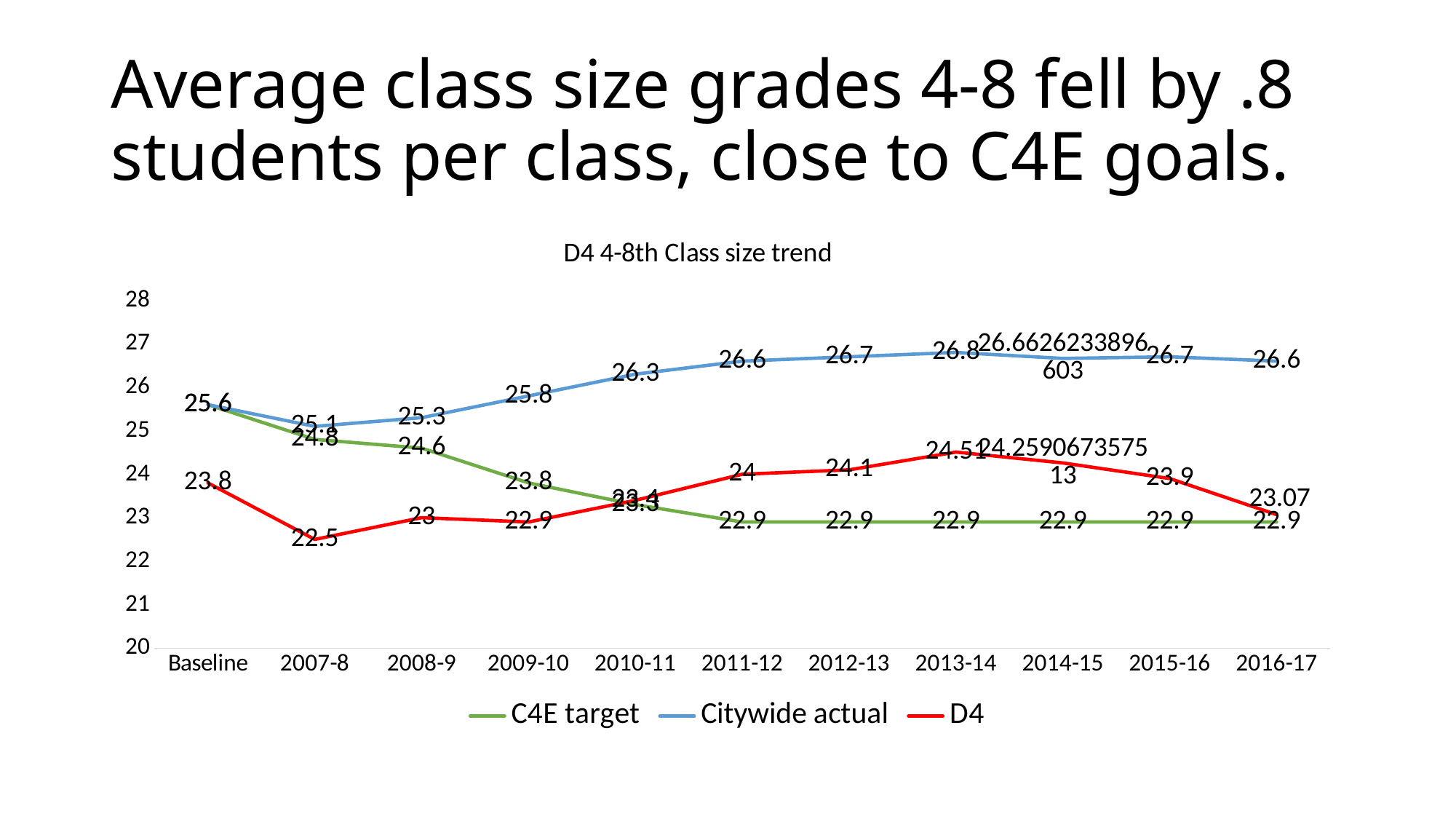
What is the Citywide actual value for 2012-13? 26.7 What is the C4E target value for 2009-10? 23.8 Which is larger in 2013-14, the D4 value or the C4E target value? D4 What colour is the D4 line? red What is the D4 value for 2016-17? 23.07 How many series does the legend list? 3 In which year is the Citywide actual value highest? 2013-14 In which year is the D4 value lowest? 2007-8 How many categories are shown on the x axis? 11 Does the C4E target line rise or fall from Baseline to 2016-17? fall What is the difference between the Citywide actual and D4 values in 2016-17? 3.53 What kind of chart is shown on the slide? line chart